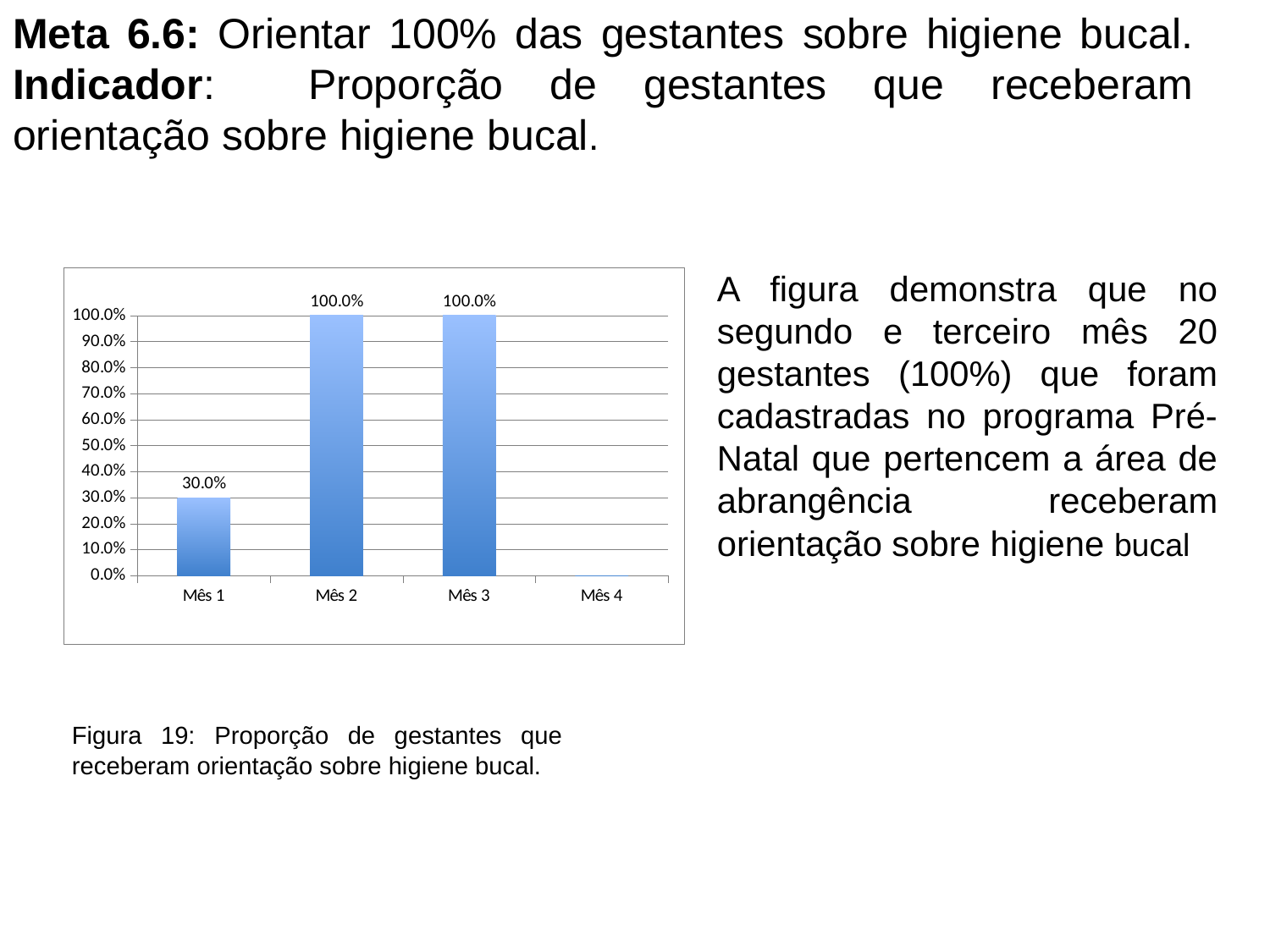
What is the value for Mês 2? 100.0% Is the value for Mês 1 greater or less than 50.0%? less How many months are shown on the x axis? 4 What figure number is given in the caption below the chart? Figura 19 Which is larger, the value for Mês 1 or the value for Mês 3? Mês 3 Which month has the lowest value? Mês 4 Is the value for Mês 4 greater or less than 10.0%? less What kind of chart is shown? bar chart Does the value rise or fall from Mês 1 to Mês 2? rise What is the value for Mês 3? 100.0% What is the difference between the values for Mês 2 and Mês 1? 70.0% What is the value for Mês 1? 30.0%